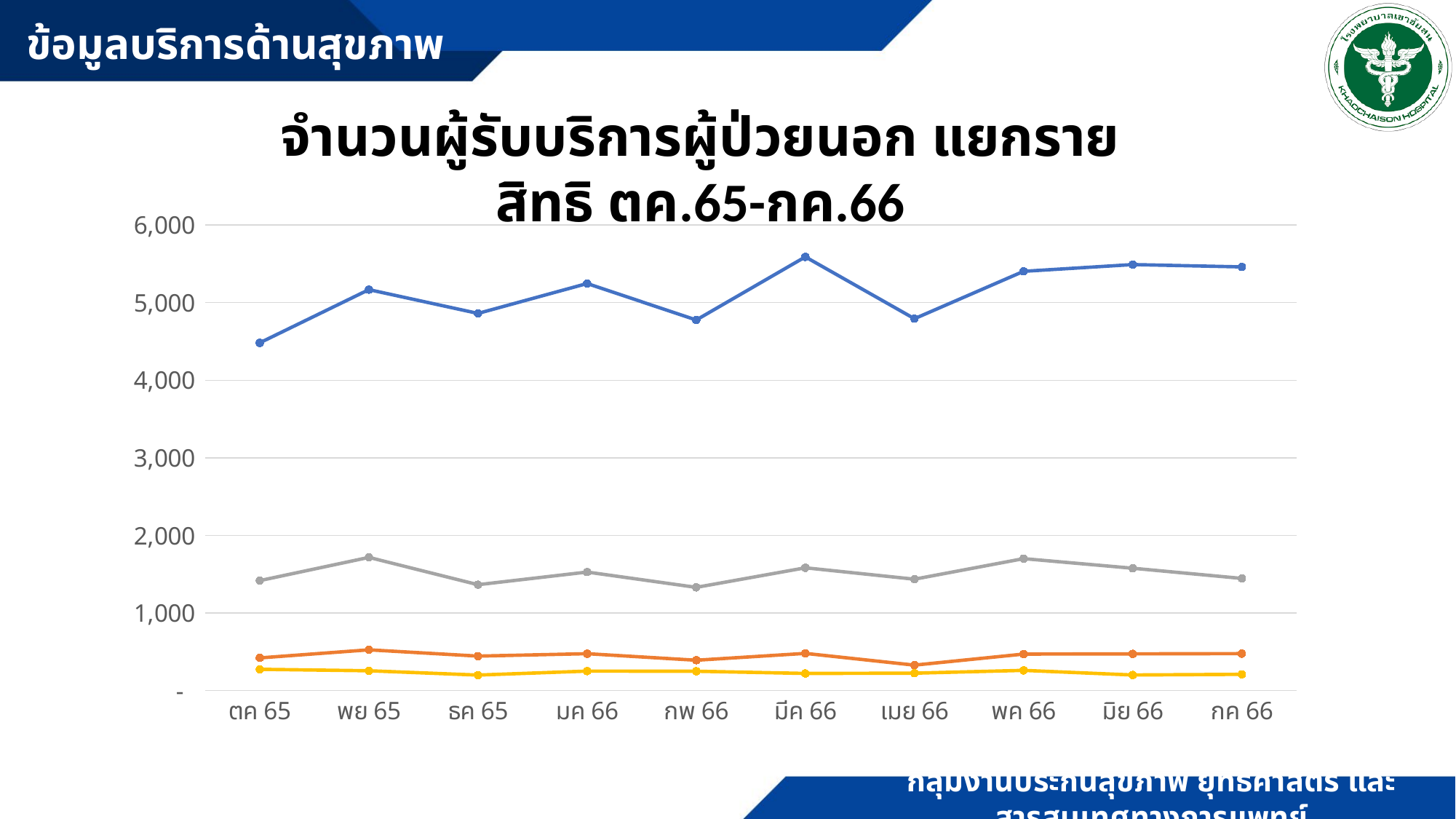
At มค 66, which line has the larger value, the blue line or the gray line? blue line In which month does the blue line reach its lowest value? ตค 65 At ตค 65, which line has the larger value, the orange line or the yellow line? orange line Is the value of the gray line at พย 65 greater or less than 2,000? less How many lines are plotted on the chart? 4 Is the value of the blue line at ตค 65 greater or less than 5,000? less Is the value of the gray line at กพ 66 greater or less than 1,000? greater How many months are plotted along the x axis of the chart? 10 What kind of chart is shown on the slide? line chart What is the title of the chart? จำนวนผู้รับบริการผู้ป่วยนอก แยกรายสิทธิ ตค.65-กค.66